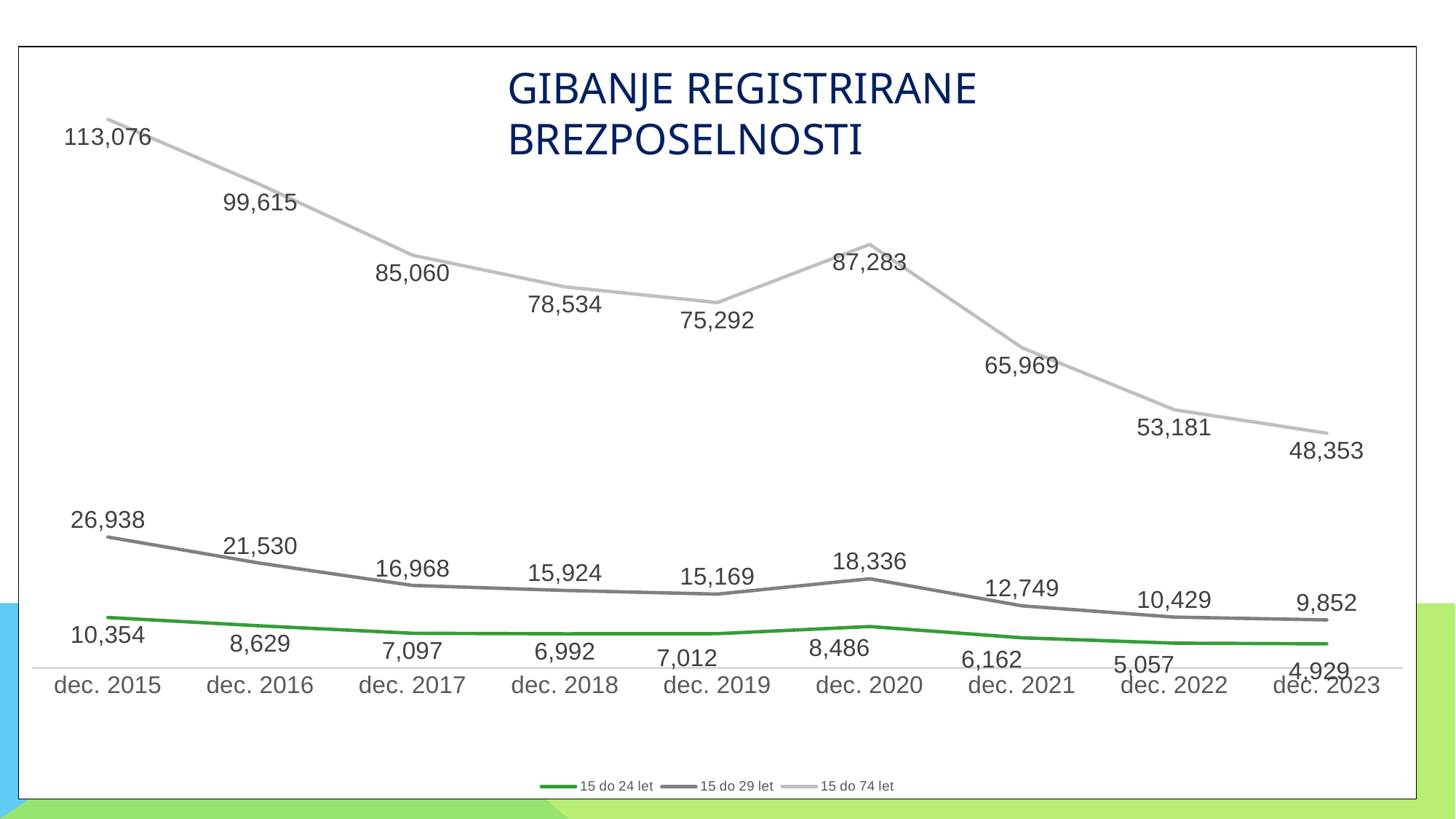
In which period is the 15 do 74 let series at its highest? dec. 2015 What is the value for the 15 do 24 let series in dec. 2023? 4,929 How many time points are shown on the x axis? 9 In which period is the 15 do 24 let series at its lowest? dec. 2023 What is the title of the chart? GIBANJE REGISTRIRANE BREZPOSELNOSTI How many series does the legend list? 3 What type of chart is shown on the slide? line chart Which is larger for the 15 do 29 let series: dec. 2019 or dec. 2020? dec. 2020 What is the value for the 15 do 74 let series in dec. 2020? 87,283 What is the value for the 15 do 29 let series in dec. 2017? 16,968 Overall, do the values of the 15 do 74 let series rise or fall from dec. 2015 to dec. 2023? fall What is the difference between the 15 do 74 let values in dec. 2015 and dec. 2023? 64,723